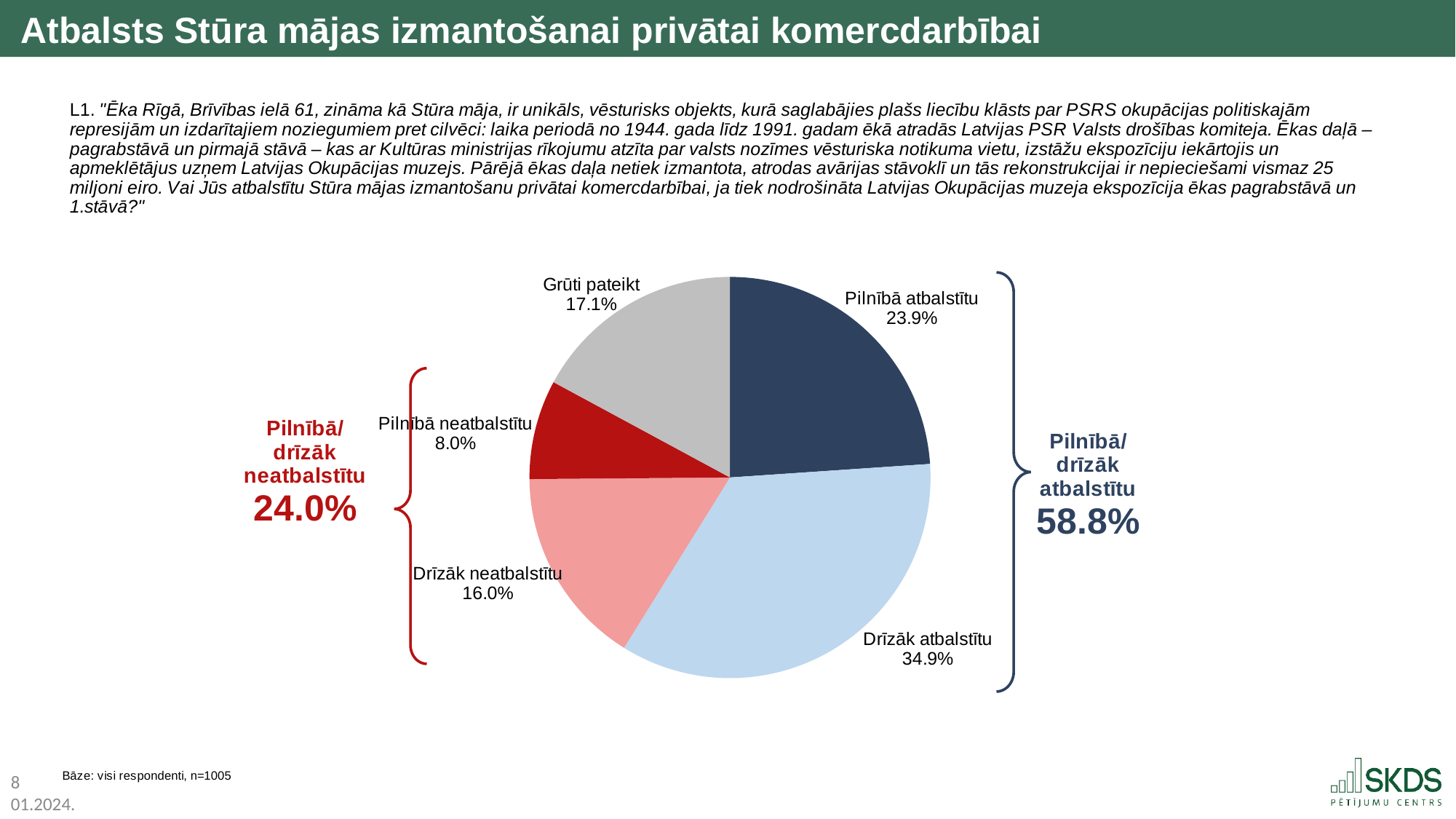
Which response category has the largest slice of the pie? Drīzāk atbalstītu What is the difference in percentage points between "Drīzāk atbalstītu" and "Drīzāk neatbalstītu"? 18.9 What combined percentage is shown for "Pilnībā/drīzāk atbalstītu"? 58.8% What share of respondents answered "Drīzāk atbalstītu"? 34.9% What kind of chart is shown on the slide? pie chart What share of respondents answered "Pilnībā neatbalstītu"? 8.0% Which response category has the smallest slice of the pie? Pilnībā neatbalstītu What share of respondents answered "Grūti pateikt"? 17.1% What share of respondents answered "Pilnībā atbalstītu"? 23.9% How many slices does the pie chart have? 5 What combined percentage is shown for "Pilnībā/drīzāk neatbalstītu"? 24.0% Which is larger, the share for "Pilnībā atbalstītu" or the share for "Grūti pateikt"? Pilnībā atbalstītu